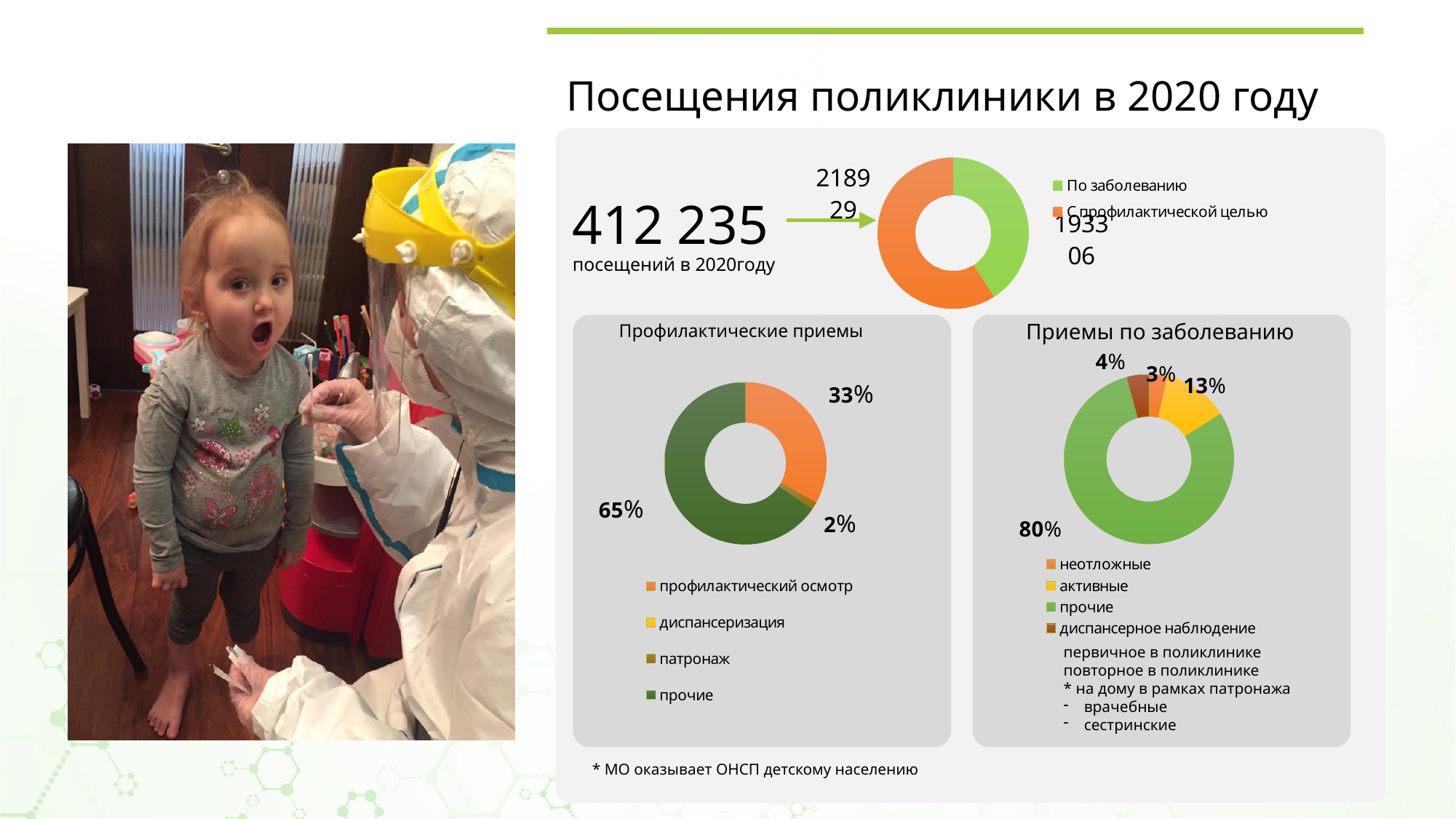
In the chart titled "Профилактические приемы", what is the difference in percentage points between "прочие" and "профилактический осмотр"? 32 percentage points In the chart titled "Приемы по заболеванию", what share is labelled for "активные"? 13% In the chart titled "Приемы по заболеванию", by how many percentage points does "активные" exceed "диспансерное наблюдение"? 9 percentage points In the chart titled "Приемы по заболеванию", which category has the largest share? прочие What kind of chart is used for the top chart next to the number 412 235? Donut (pie) chart In the chart titled "Профилактические приемы", what share is labelled for "прочие"? 65% In the chart titled "Приемы по заболеванию", what share is labelled for "диспансерное наблюдение"? 4% In the chart titled "Приемы по заболеванию", what share is labelled for "прочие"? 80% In the chart titled "Приемы по заболеванию", which category has the smallest share? неотложные In the chart titled "Приемы по заболеванию", what share is labelled for "неотложные"? 3% How many entries does the legend of the chart titled "Профилактические приемы" list? 4 In the chart titled "Профилактические приемы", what share is labelled for "профилактический осмотр"? 33%